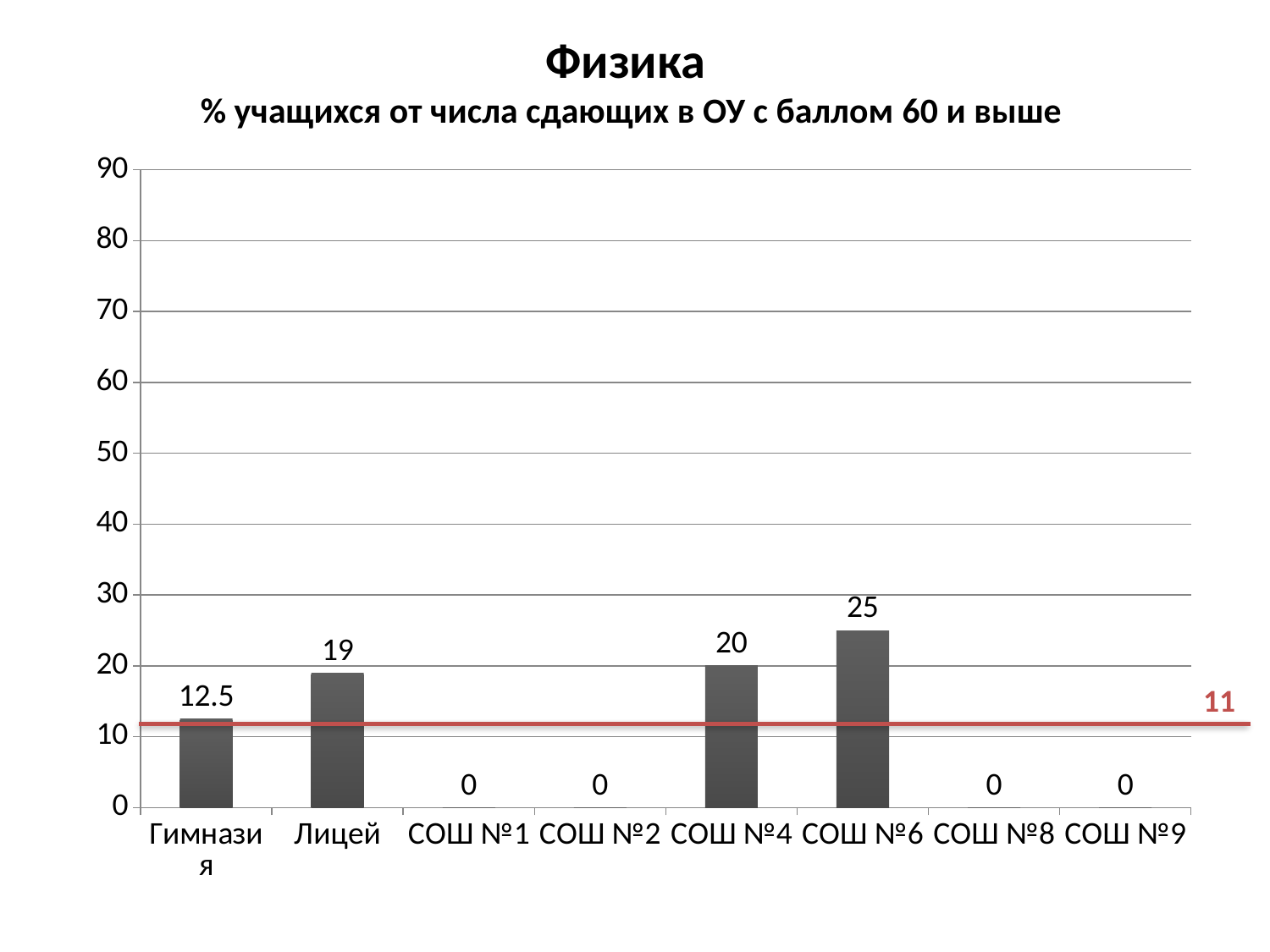
What value does the red horizontal line mark? 11 What is the title of the chart? Физика What is the value for Гимназия? 12.5 Which is larger, the value for СОШ №4 or the value for Гимназия? СОШ №4 What is the value for Лицей? 19 What is the value for СОШ №6? 25 What is the value for СОШ №4? 20 How many categories have a value of 0? 4 What is the difference between the values for СОШ №6 and Лицей? 6 Which category has the highest value? СОШ №6 What kind of chart is this? bar chart How many categories are shown on the x axis? 8